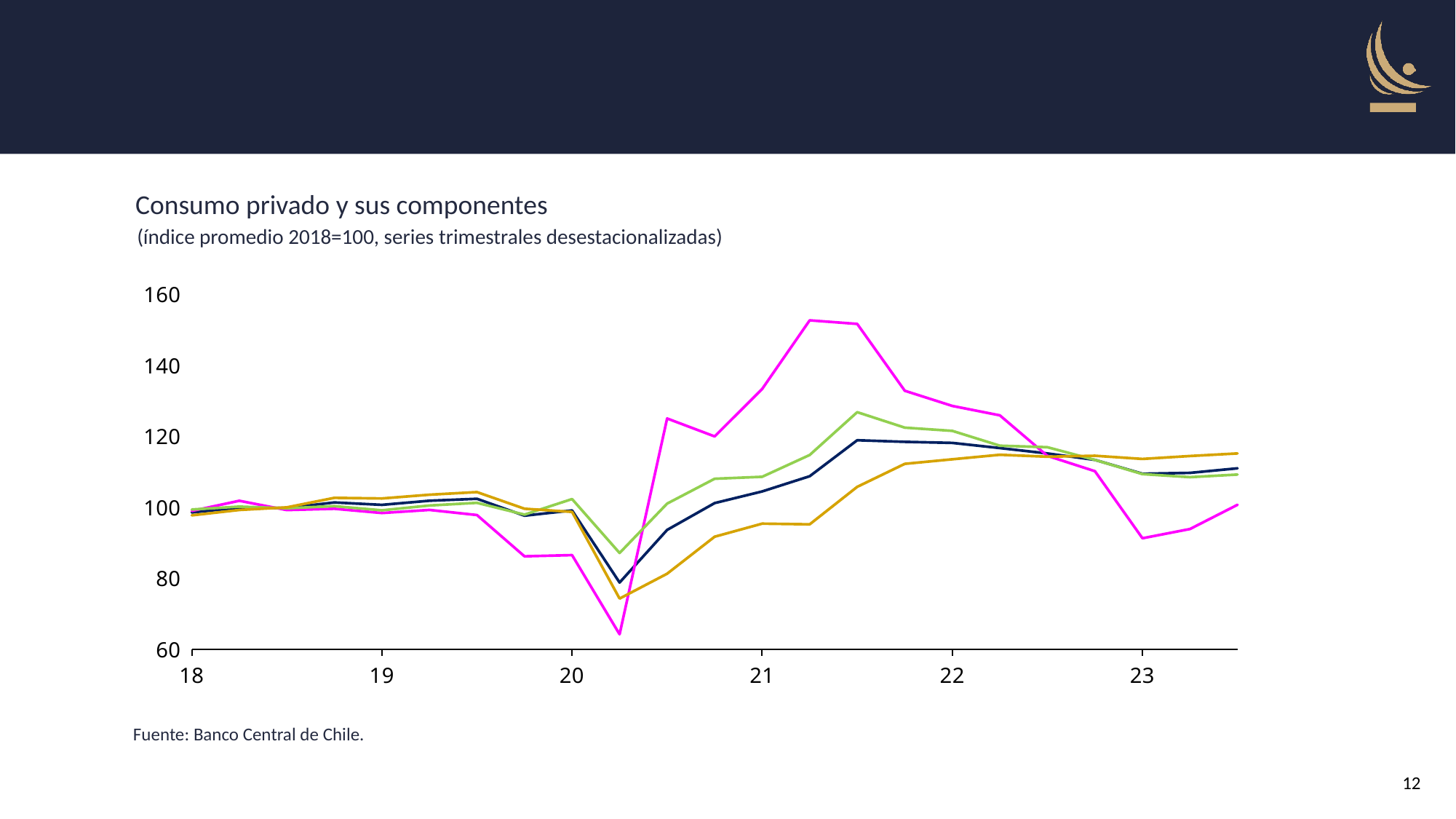
Which line reaches the lowest value on the chart? the magenta line Which line reaches the highest value on the chart? the magenta line Is the lowest value of the orange line greater or less than 80? less At its lowest point in 2020, is the magenta line above or below the orange line? below Is the peak value of the green line greater or less than 120? greater Is the peak value of the magenta line greater or less than 140? greater How many year labels are shown on the x axis? 6 Does the magenta line rise or fall between its 2021 peak and 2023? fall How many lines are plotted on the chart? 4 What is the title of the chart? Consumo privado y sus componentes What kind of chart is shown on the slide? line chart